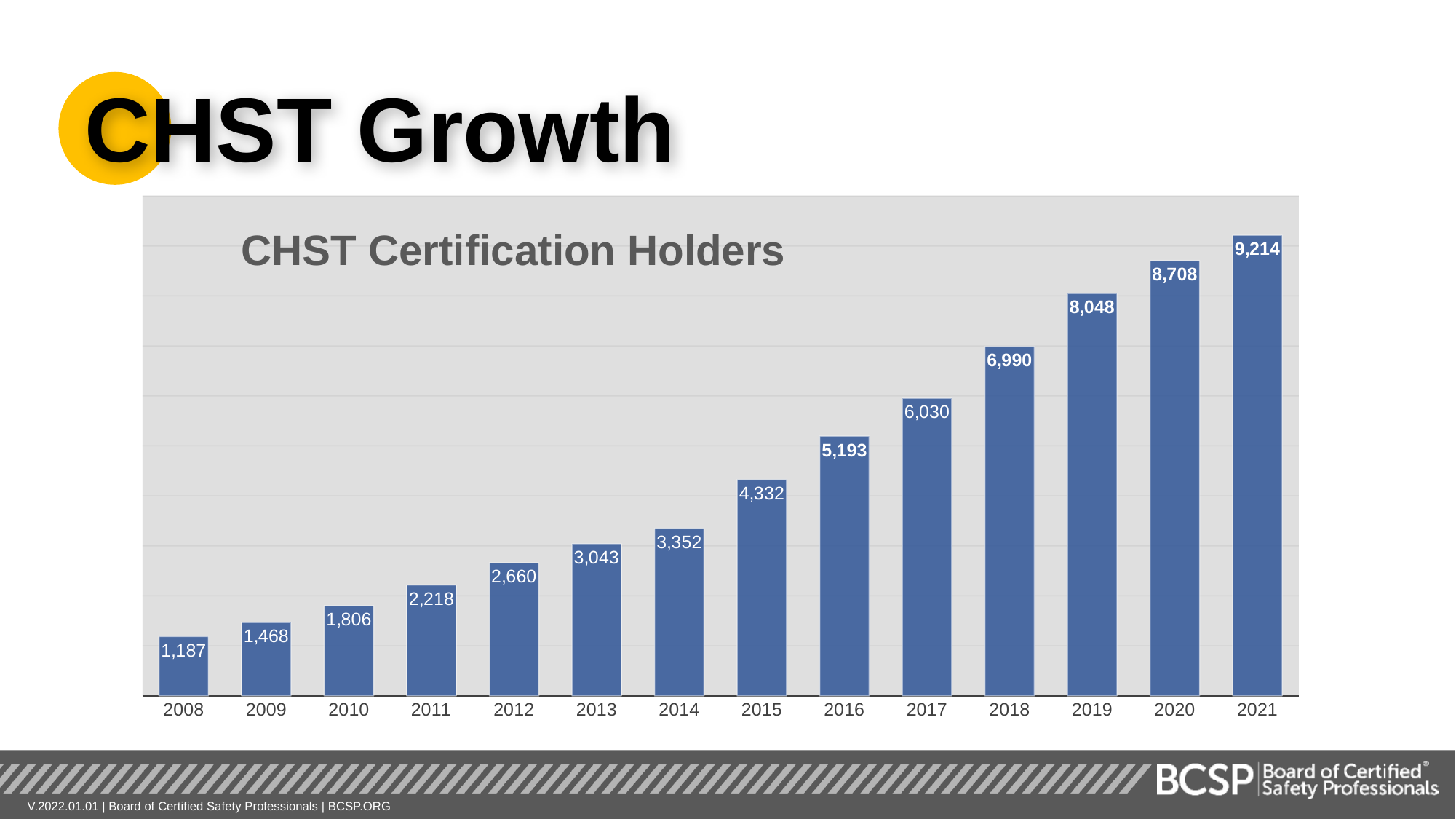
How many CHST certification holders were there in 2015? 4,332 Which year has a larger value, 2013 or 2014? 2014 How many years are shown on the x axis of the chart? 14 What kind of chart is shown on the slide? Bar chart What is the difference between the values for 2016 and 2015? 861 Which year has the highest number of CHST certification holders? 2021 Which year has the lowest number of CHST certification holders? 2008 What is the value shown for 2019? 8,048 What is the difference between the values for 2021 and 2020? 506 What is the title of the chart? CHST Certification Holders What is the value for 2008 in the CHST Certification Holders chart? 1,187 Do the values rise or fall from 2008 to 2021? Rise